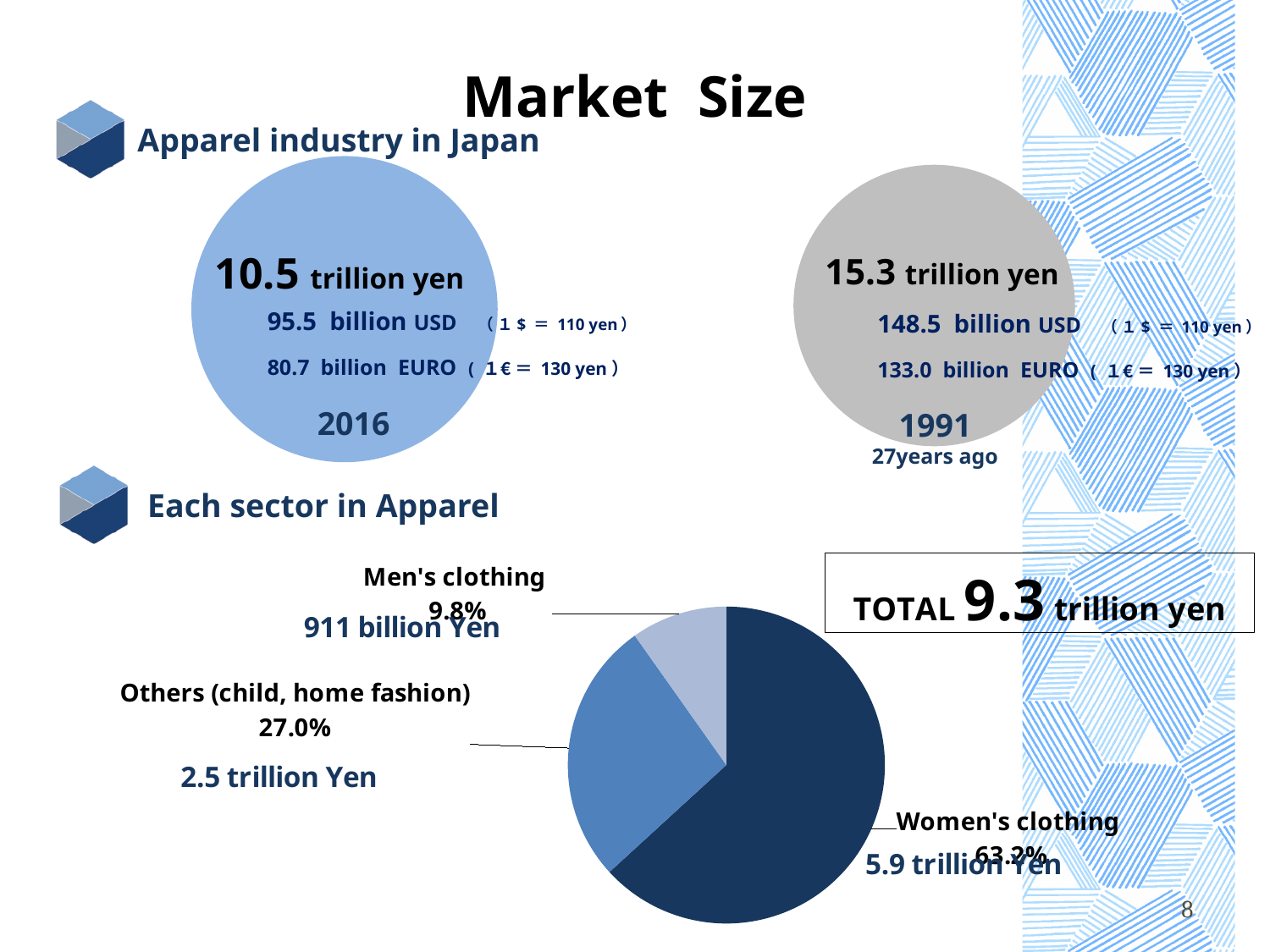
In the pie chart, which is larger: the share for Others (child, home fashion) or the share for Men's clothing? Others (child, home fashion) Which sector has the largest slice in the pie chart? Women's clothing What is the difference in percentage points between the Women's clothing share and the Others (child, home fashion) share in the pie chart? 36.2 In the pie chart, what percentage share does Women's clothing have? 63.2% What value in yen is given for the Women's clothing sector in the pie chart? 5.9 trillion Yen In the pie chart, what percentage share does Men's clothing have? 9.8% What kind of chart is shown in the 'Each sector in Apparel' section? pie chart How many sectors are shown in the pie chart? 3 Which sector has the smallest slice in the pie chart? Men's clothing In the pie chart, what percentage share does Others (child, home fashion) have? 27.0% What is the total value stated for the pie chart of each sector in Apparel? 9.3 trillion yen What value in yen is given for the Men's clothing sector in the pie chart? 911 billion Yen